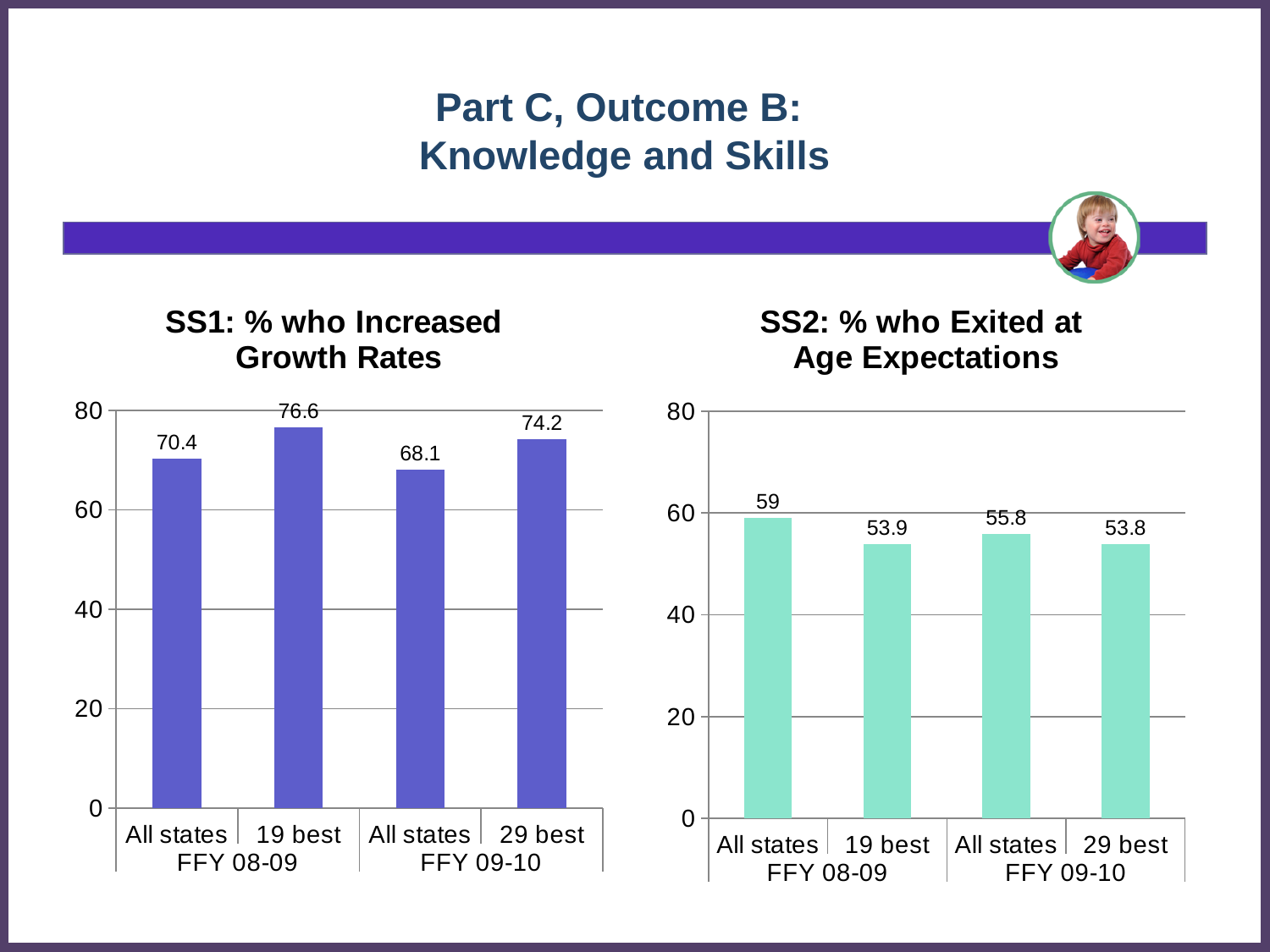
In the SS1: % who Increased Growth Rates chart, what is the difference between 19 best in FFY 08-09 and All states in FFY 08-09? 6.2 In the SS2: % who Exited at Age Expectations chart, what is the value for 19 best in FFY 08-09? 53.9 How many bars are plotted in the SS1: % who Increased Growth Rates chart? 4 In the SS2: % who Exited at Age Expectations chart, is the value for All states in FFY 09-10 larger or smaller than the value for All states in FFY 08-09? smaller In the SS1: % who Increased Growth Rates chart, which bar is the highest? 19 best, FFY 08-09 In the SS2: % who Exited at Age Expectations chart, which bar is the highest? All states, FFY 08-09 In the SS2: % who Exited at Age Expectations chart, what is the difference between All states in FFY 09-10 and 29 best in FFY 09-10? 2 What kind of chart is the SS2: % who Exited at Age Expectations chart? bar chart In the SS1: % who Increased Growth Rates chart, what is the value for 29 best in FFY 09-10? 74.2 In the SS1: % who Increased Growth Rates chart, what is the value for All states in FFY 08-09? 70.4 In the SS1: % who Increased Growth Rates chart, which bar is the lowest? All states, FFY 09-10 In the SS2: % who Exited at Age Expectations chart, what is the value for All states in FFY 08-09? 59